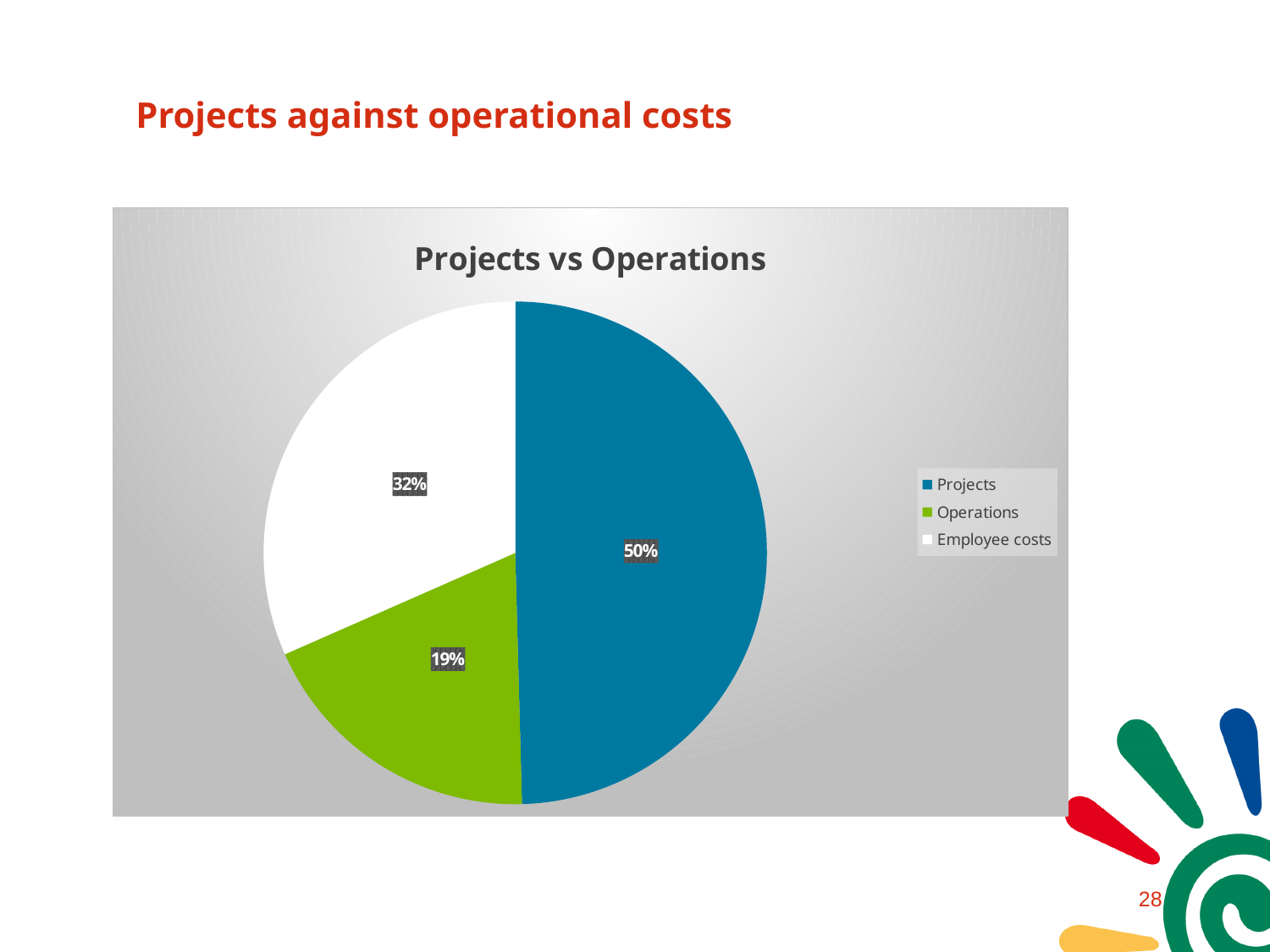
What share of the pie does Operations take? 19% What share of the pie does Employee costs take? 32% What colour is the Operations slice? green What share of the pie does Projects take? 50% Which category has the largest slice of the pie? Projects Which slice is larger, Operations or Employee costs? Employee costs What is the difference in percentage points between the Projects slice and the Employee costs slice? 18 How many slices does the pie chart have? 3 What type of chart is shown on the slide? pie chart Which category has the smallest slice of the pie? Operations How many entries does the legend list? 3 What is the title of the chart? Projects vs Operations